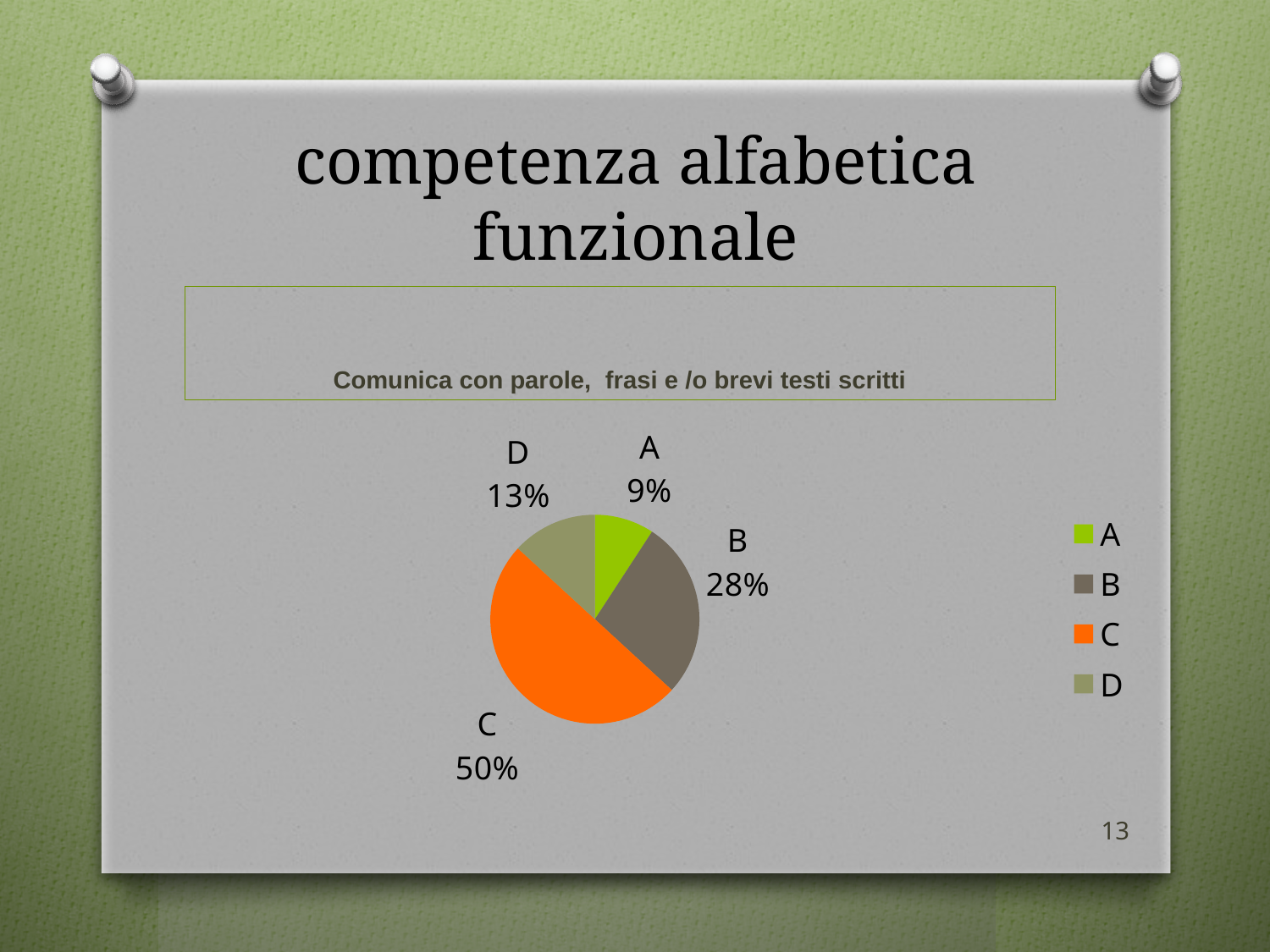
Which is larger, the share for B or the share for D? B What colour is the slice for category C? orange Which category has the largest share of the pie? C What is the difference in percentage points between slice C and slice B? 22 How many slices does the pie chart have? 4 What percentage does slice C represent? 50% What percentage does slice A represent? 9% How many entries does the legend list? 4 Which category has the smallest share of the pie? A What percentage does slice B represent? 28% What kind of chart is shown on the slide? pie chart What percentage does slice D represent? 13%